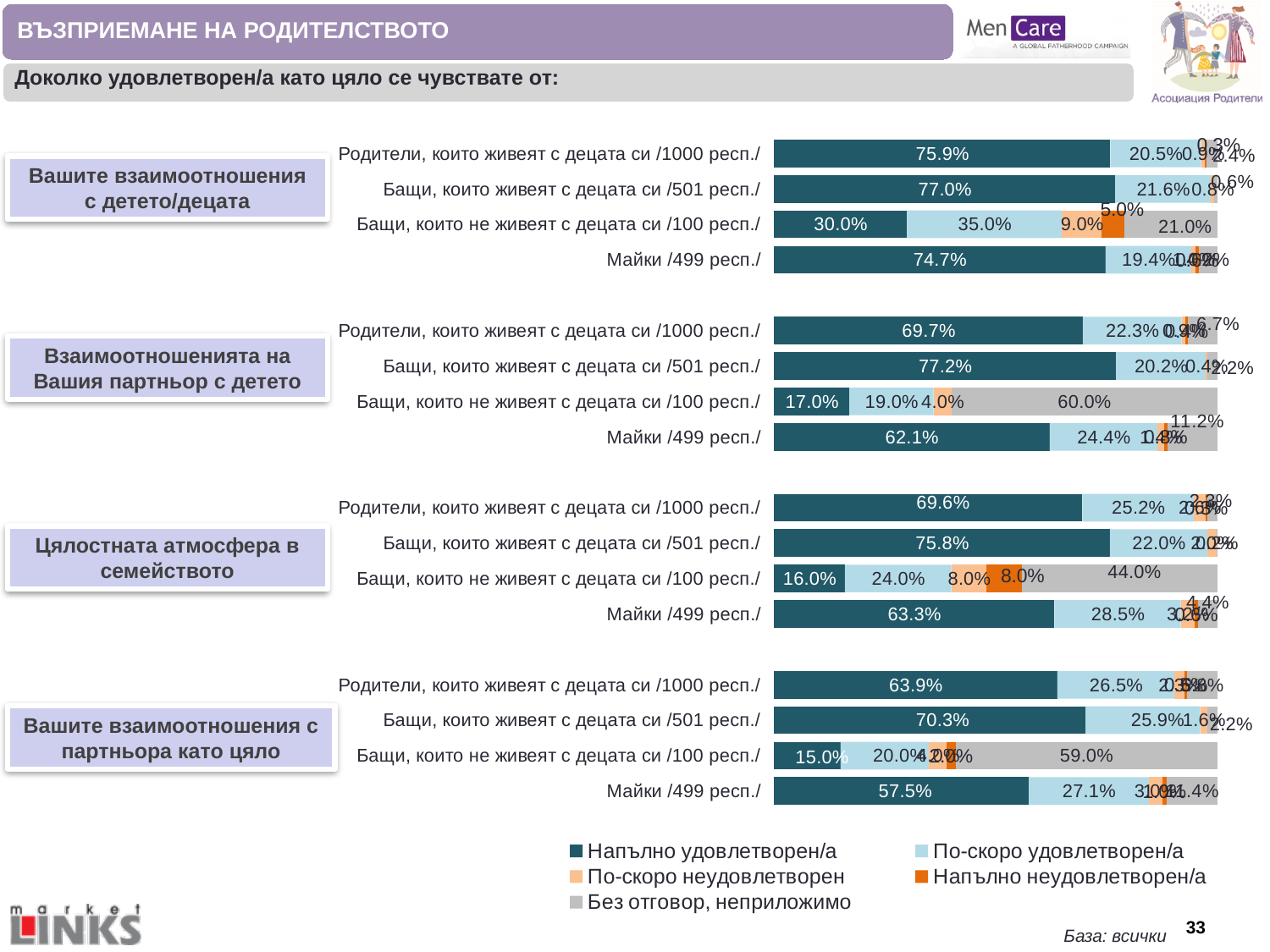
In the chart section 'Вашите взаимоотношения с детето/децата', what is the difference between the 'Напълно удовлетворен/а' values for 'Бащи, които живеят с децата си /501 респ./' and 'Майки /499 респ./'? 2.3% How many series does the legend list? 5 In the chart section 'Вашите взаимоотношения с детето/децата', what is the 'Без отговор, неприложимо' value for 'Бащи, които не живеят с децата си /100 респ./'? 21.0% How many respondent groups are shown in each chart section on the slide? 4 In the chart section 'Взаимоотношенията на Вашия партньор с детето', which respondent group has the highest 'Напълно удовлетворен/а' value? Бащи, които живеят с децата си /501 респ./ In the chart section 'Цялостната атмосфера в семейството', which respondent group has the lowest 'Напълно удовлетворен/а' value? Бащи, които не живеят с децата си /100 респ./ In the chart section 'Цялостната атмосфера в семейството', what is the 'По-скоро удовлетворен/а' value for 'Майки /499 респ./'? 28.5% In the chart section 'Вашите взаимоотношения с партньора като цяло', which is larger: the 'Напълно удовлетворен/а' value for 'Родители, които живеят с децата си /1000 респ./' or for 'Бащи, които живеят с децата си /501 респ./'? Бащи, които живеят с децата си /501 респ./ In the chart section 'Вашите взаимоотношения с детето/децата', what is the 'Напълно удовлетворен/а' value for 'Бащи, които живеят с децата си /501 респ./'? 77.0% What kind of chart is used on the slide? Stacked bar chart In the chart section 'Взаимоотношенията на Вашия партньор с детето', what is the 'Без отговор, неприложимо' value for 'Бащи, които не живеят с децата си /100 респ./'? 60.0% In the chart section 'Вашите взаимоотношения с партньора като цяло', what is the 'Напълно удовлетворен/а' value for 'Майки /499 респ./'? 57.5%